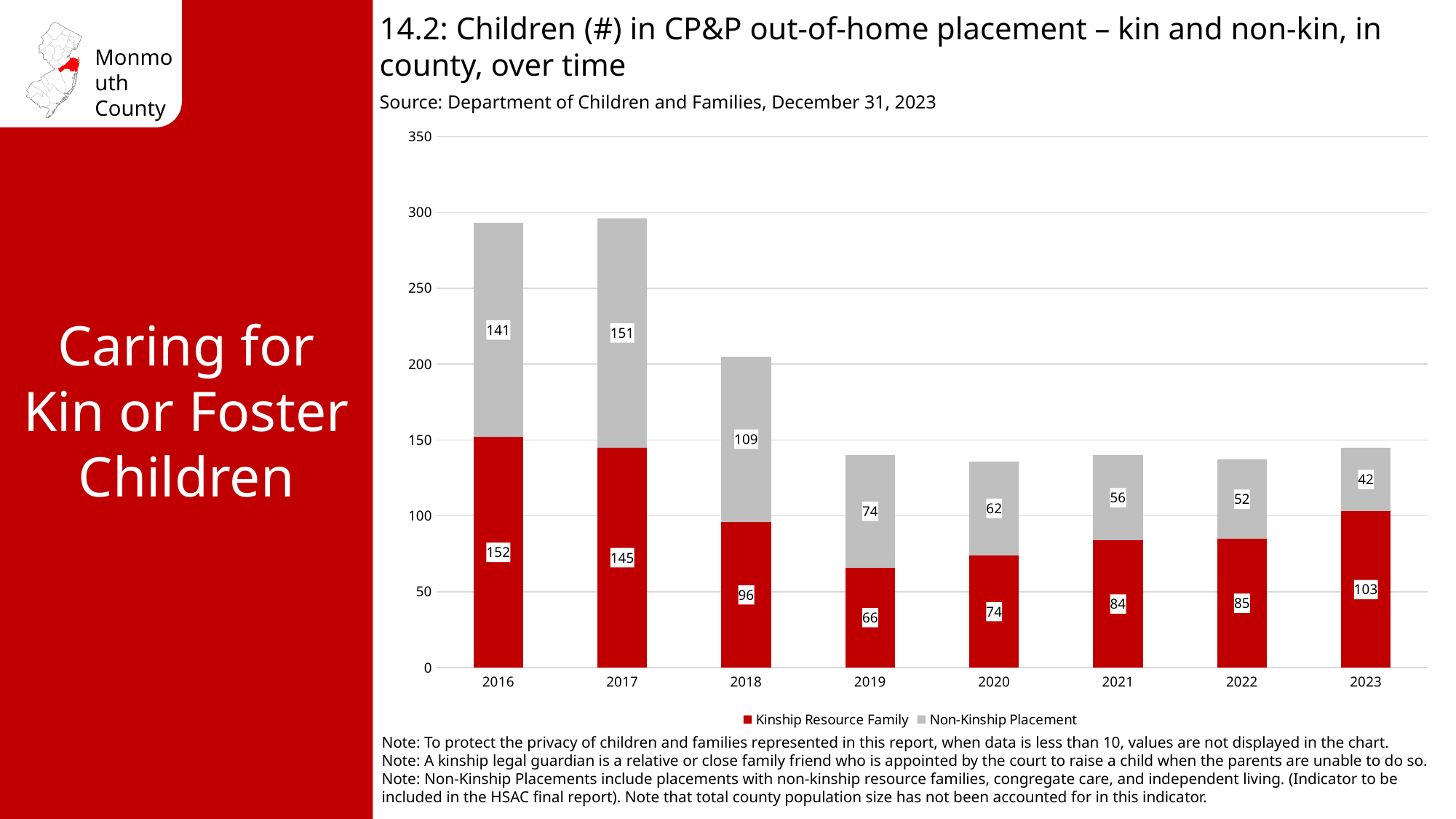
Which year has the highest Non-Kinship Placement value? 2017 What is the Kinship Resource Family value for 2016? 152 How many series does the legend list? 2 What kind of chart is shown on the slide? Stacked bar chart Which is larger in 2018: the Kinship Resource Family value or the Non-Kinship Placement value? Non-Kinship Placement How many years are shown on the x axis? 8 What is the difference between the Non-Kinship Placement values for 2017 and 2023? 109 What is the Non-Kinship Placement value for 2023? 42 What is the total of the stacked bar for 2016? 293 Which year has the lowest Kinship Resource Family value? 2019 What is the total of the stacked bar for 2023? 145 What is the Kinship Resource Family value for 2019? 66